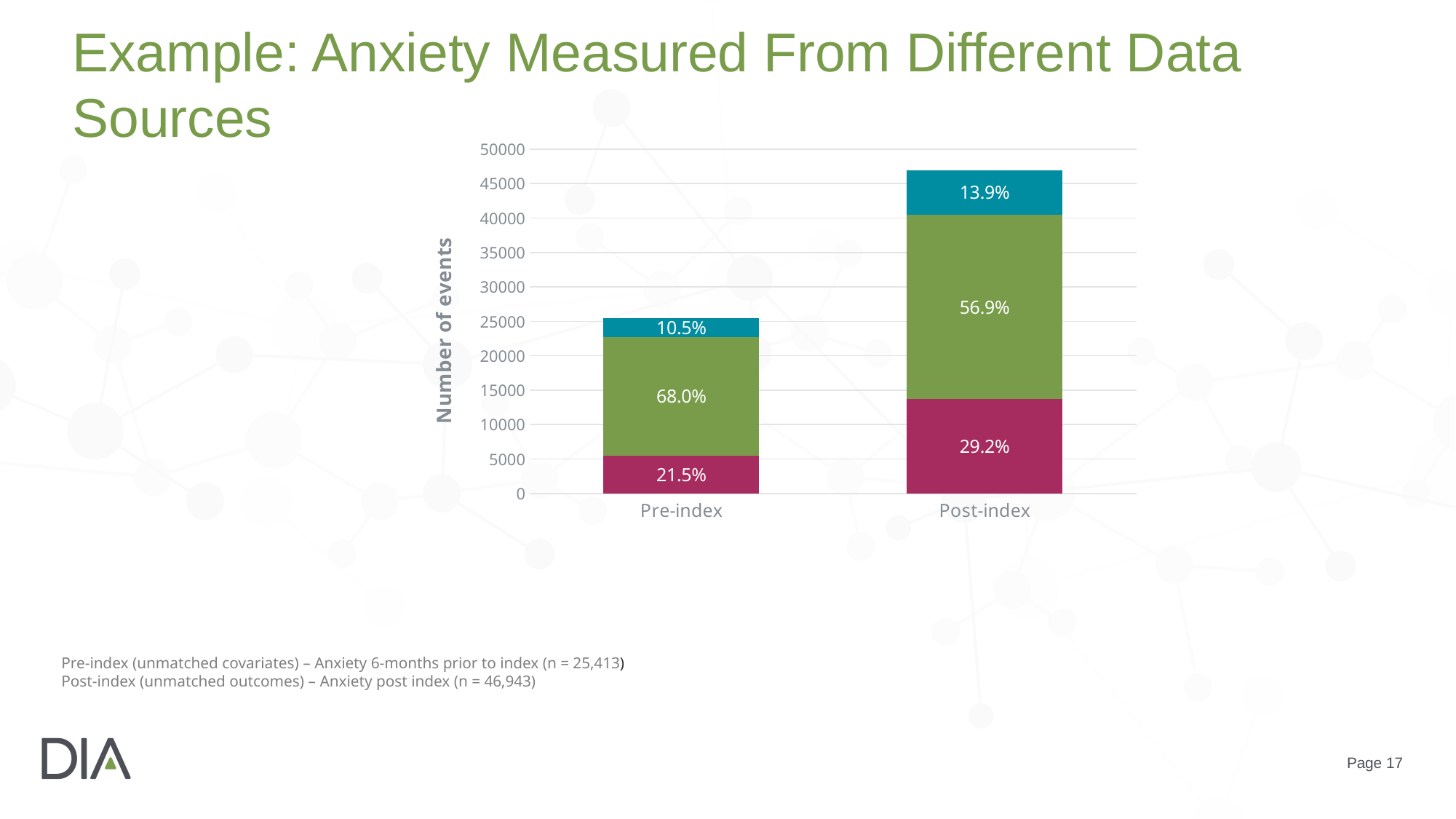
What is the label of the y axis of the chart? Number of events Is the total number of events for the Pre-index bar greater or less than 30000? less How many segments make up each stacked bar in the chart? 3 What percentage is shown on the middle (green) segment of the Pre-index bar? 68.0% Which bar is taller in total number of events, Pre-index or Post-index? Post-index What percentage is shown on the top (teal) segment of the Post-index bar? 13.9% How many categories are shown on the x axis of the chart? 2 Is the total number of events for the Post-index bar greater or less than 45000? greater What percentage is shown on the middle (green) segment of the Post-index bar? 56.9% What kind of chart is shown on the slide? Stacked bar chart What percentage is shown on the bottom (magenta) segment of the Pre-index bar? 21.5% By how many percentage points does the green segment's share in the Pre-index bar exceed the green segment's share in the Post-index bar? 11.1 percentage points